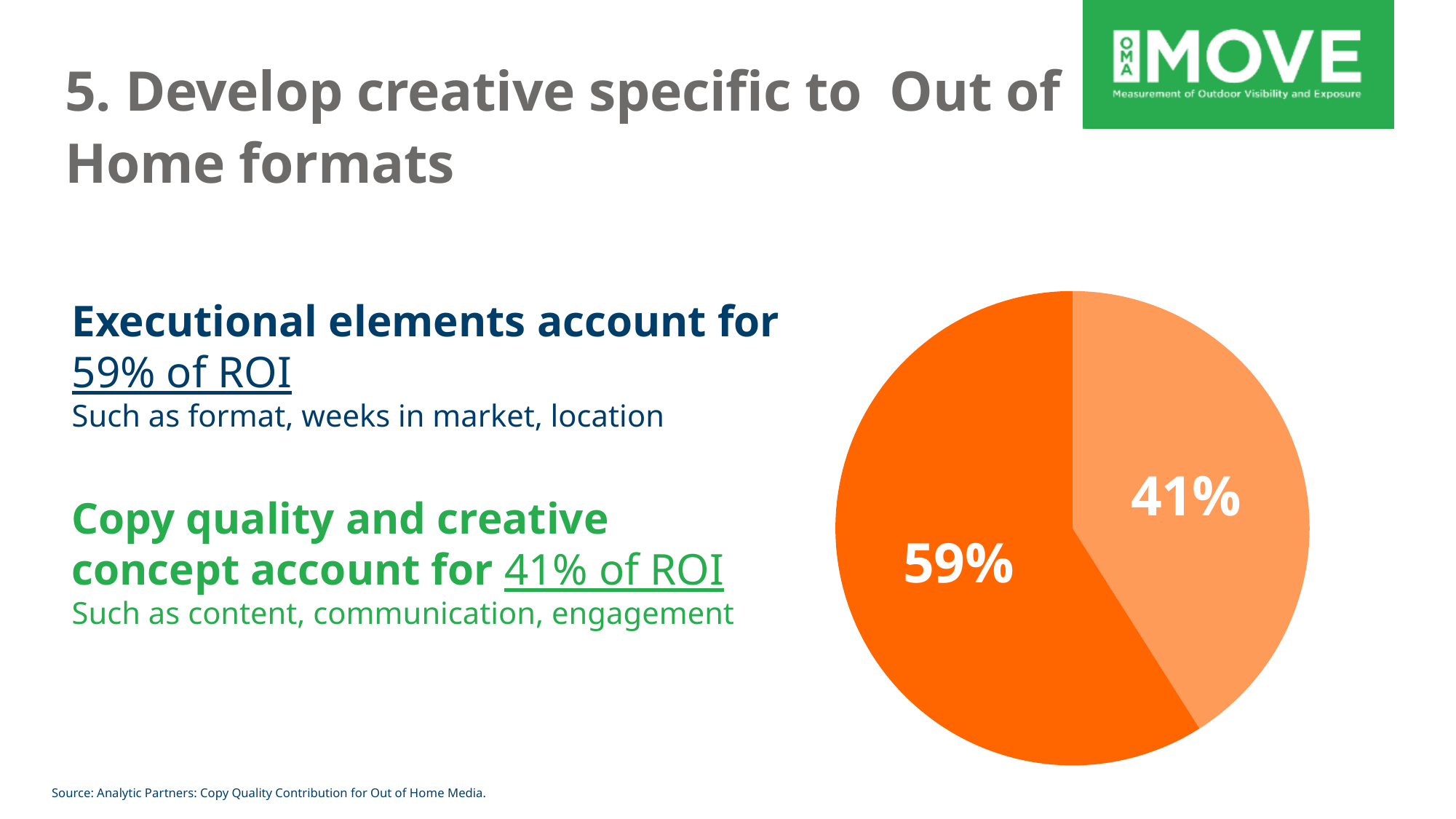
What is the value shown on the smaller slice of the pie chart? 41% Is the value of the darker orange slice greater or less than 50%? greater What kind of chart is shown on the slide? pie chart What is the value shown on the larger slice of the pie chart? 59% Is the value of the lighter orange slice greater or less than 50%? less What is the largest value shown in the pie chart? 59% What do the two slices of the pie chart add up to? 100% How many slices does the pie chart have? 2 Which slice of the pie chart is shown in the lighter orange colour, the 59% slice or the 41% slice? 41% Which slice of the pie chart is larger, the 59% slice or the 41% slice? 59% What is the smallest value shown in the pie chart? 41% What is the difference between the two slices of the pie chart? 18%